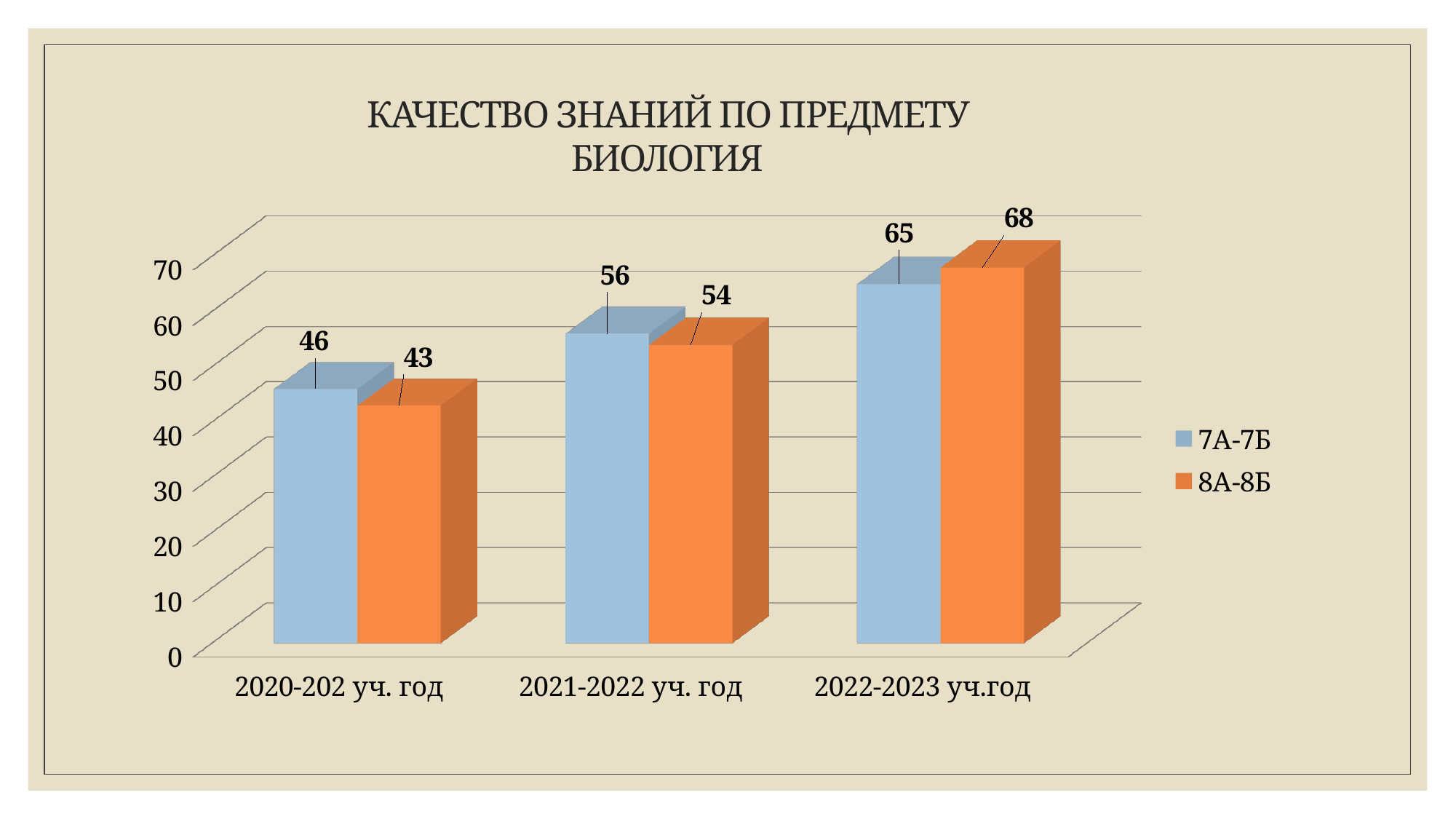
In which year is the value for 8А-8Б lowest? 2020-202 уч. год Which series has the larger value in 2022-2023 уч.год, 7А-7Б or 8А-8Б? 8А-8Б What is the value for 7А-7Б in 2021-2022 уч. год? 56 What kind of chart is shown on the slide? Bar chart How many years are shown on the x axis? 3 In which year is the value for 7А-7Б highest? 2022-2023 уч.год How many series does the legend list? 2 What is the value for 8А-8Б in 2022-2023 уч.год? 68 What is the title of the chart? КАЧЕСТВО ЗНАНИЙ ПО ПРЕДМЕТУ БИОЛОГИЯ Do the values for 7А-7Б rise or fall from 2020-202 уч. год to 2022-2023 уч.год? Rise What is the value for 8А-8Б in 2020-202 уч. год? 43 What is the difference between the 7А-7Б and 8А-8Б values in 2020-202 уч. год? 3